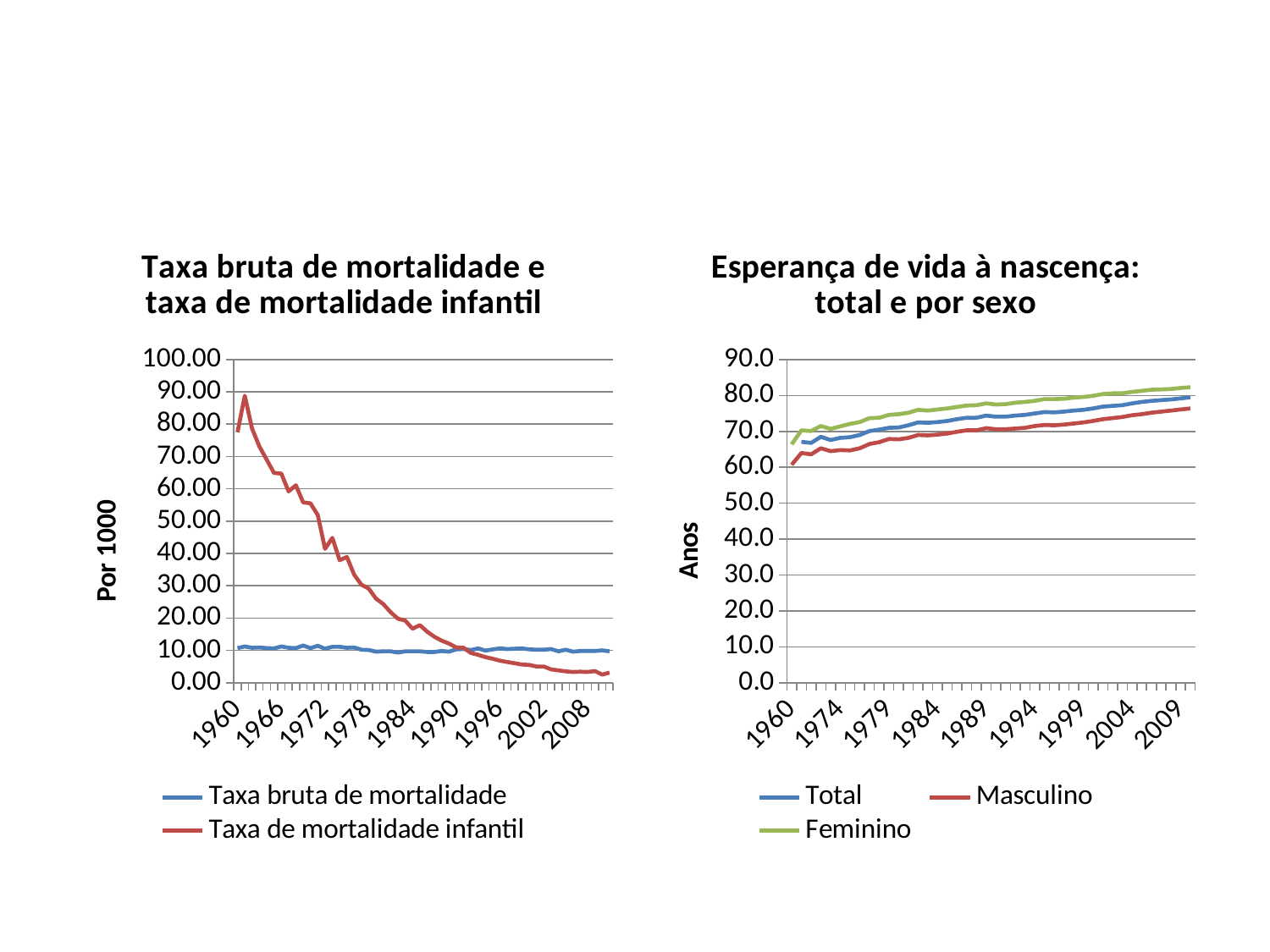
How many series does the legend list in the chart titled "Taxa bruta de mortalidade e taxa de mortalidade infantil"? 2 What is the y-axis label of the chart titled "Esperança de vida à nascença: total e por sexo"? Anos In the chart titled "Taxa bruta de mortalidade e taxa de mortalidade infantil", does the Taxa de mortalidade infantil series rise or fall from 1960 to 2008? Fall In the chart titled "Esperança de vida à nascença: total e por sexo", does the Feminino series rise or fall from 1960 to 2009? Rise In the chart titled "Esperança de vida à nascença: total e por sexo", is the value of Feminino in 2009 greater or less than 80.0? greater In the chart titled "Taxa bruta de mortalidade e taxa de mortalidade infantil", which series is higher in 1966, Taxa bruta de mortalidade or Taxa de mortalidade infantil? Taxa de mortalidade infantil What kind of chart is the chart titled "Taxa bruta de mortalidade e taxa de mortalidade infantil"? Line chart In the chart titled "Esperança de vida à nascença: total e por sexo", is the value of Masculino in 1960 greater or less than 70.0? less In the chart titled "Taxa bruta de mortalidade e taxa de mortalidade infantil", is the value of Taxa de mortalidade infantil in 2008 greater or less than 10.00? less How many series does the legend list in the chart titled "Esperança de vida à nascença: total e por sexo"? 3 In the chart titled "Esperança de vida à nascença: total e por sexo", which series is higher in 2009, Feminino or Masculino? Feminino